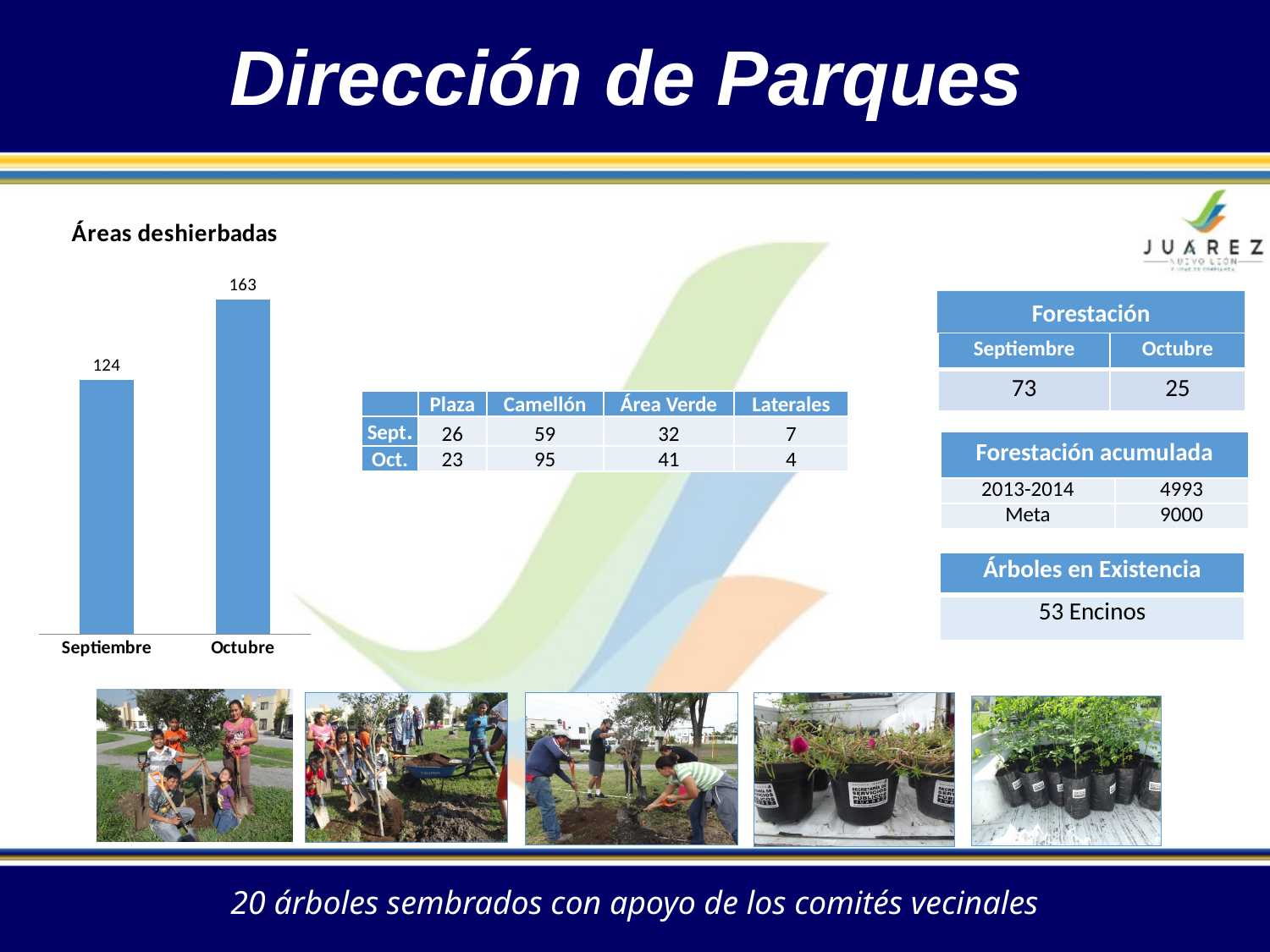
What is the difference between the Octubre and Septiembre values in the Áreas deshierbadas chart? 39 In the Áreas deshierbadas chart, is the value for Septiembre or Octubre larger? Octubre What colour are the bars in the Áreas deshierbadas chart? Blue Which month has the lowest value in the Áreas deshierbadas chart? Septiembre What is the value for Octubre in the Áreas deshierbadas chart? 163 How many categories are shown in the Áreas deshierbadas chart? 2 What is the title of the bar chart on the slide? Áreas deshierbadas Which month has the highest value in the Áreas deshierbadas chart? Octubre Do the values in the Áreas deshierbadas chart rise or fall from Septiembre to Octubre? Rise What is the value for Septiembre in the Áreas deshierbadas chart? 124 What kind of chart is the Áreas deshierbadas chart? Bar chart